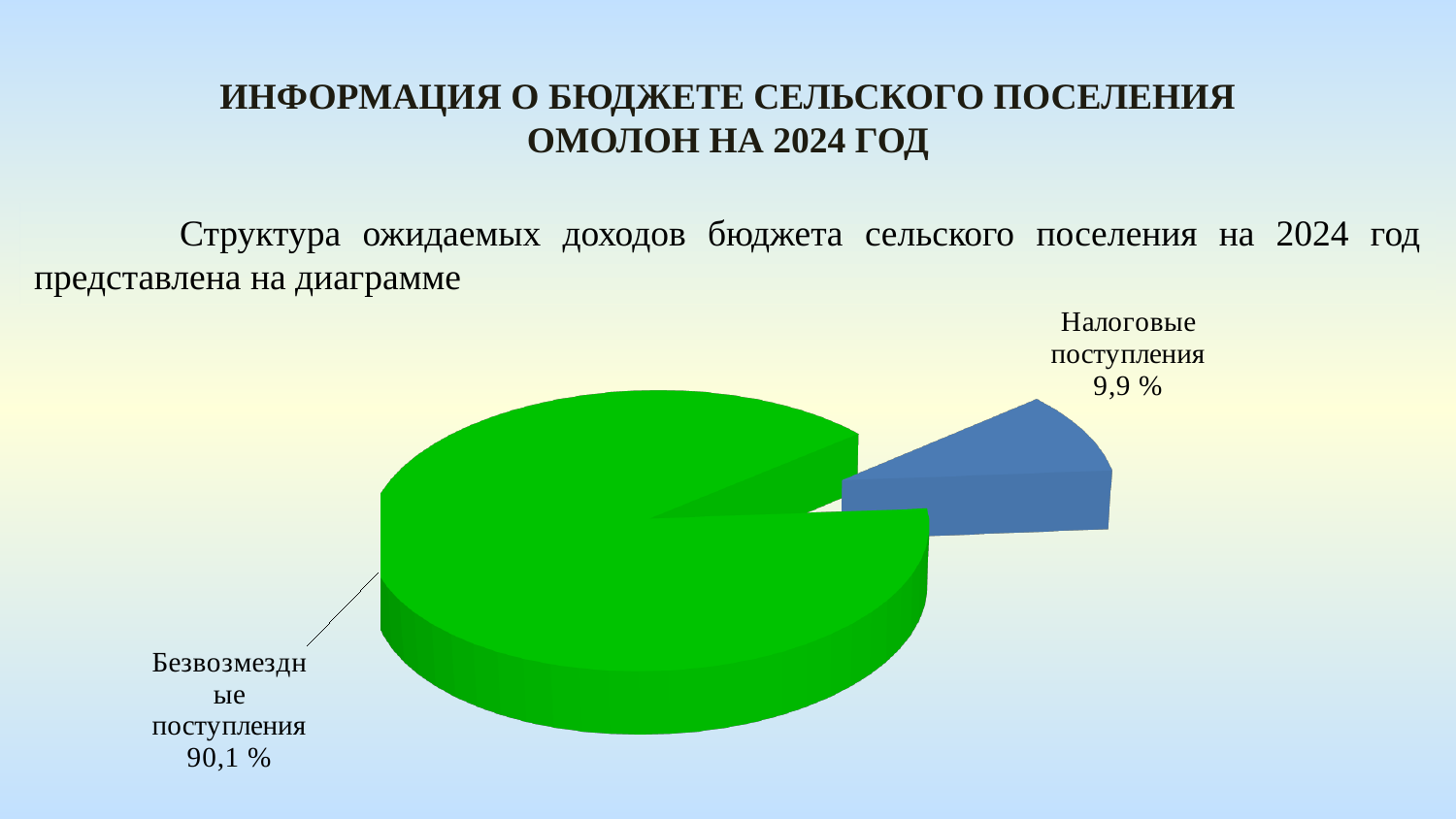
What share of the pie is labelled for Налоговые поступления? 9,9 % What colour is the slice for Налоговые поступления? Blue Which category has the smallest slice of the pie? Налоговые поступления Which category has the largest slice of the pie? Безвозмездные поступления Which is larger: the share for Налоговые поступления or the share for Безвозмездные поступления? Безвозмездные поступления What kind of chart is shown on the slide? Pie chart How many slices does the pie chart have? 2 What is the difference in percentage points between Безвозмездные поступления and Налоговые поступления? 80,2 What share of the pie is labelled for Безвозмездные поступления? 90,1 % What colour is the slice for Безвозмездные поступления? Green